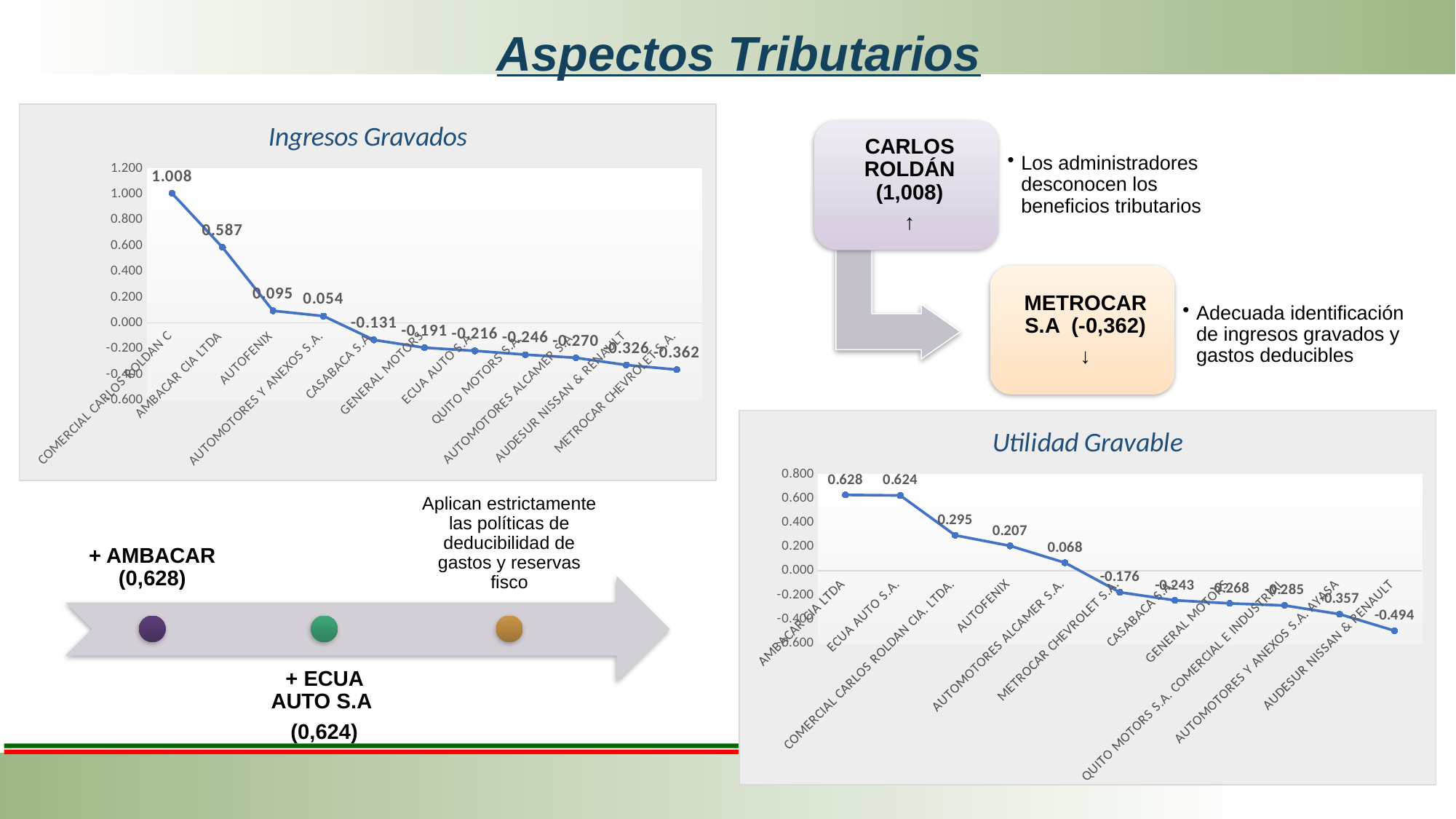
In the Ingresos Gravados chart, what is the difference between the values for COMERCIAL CARLOS ROLDAN C and AMBACAR CIA LTDA? 0.421 In the Ingresos Gravados chart, do the values rise or fall from left to right? fall What kind of chart is the Ingresos Gravados chart? line chart In the Utilidad Gravable chart, what is the difference between the values for AMBACAR CIA LTDA and ECUA AUTO S.A.? 0.004 In the Ingresos Gravados chart, what is the lowest value shown? -0.362 In the Utilidad Gravable chart, what is the value for AUDESUR NISSAN & RENAULT? -0.494 In the Utilidad Gravable chart, how many data points are plotted? 11 In the Ingresos Gravados chart, which company has the highest value? COMERCIAL CARLOS ROLDAN C In the Ingresos Gravados chart, what is the value for AMBACAR CIA LTDA? 0.587 In the Utilidad Gravable chart, what is the value for AUTOFENIX? 0.207 In the Ingresos Gravados chart, what is the value for AUTOFENIX? 0.095 In the Utilidad Gravable chart, which is larger, the value for AUTOFENIX or the value for AUTOMOTORES ALCAMER S.A.? AUTOFENIX